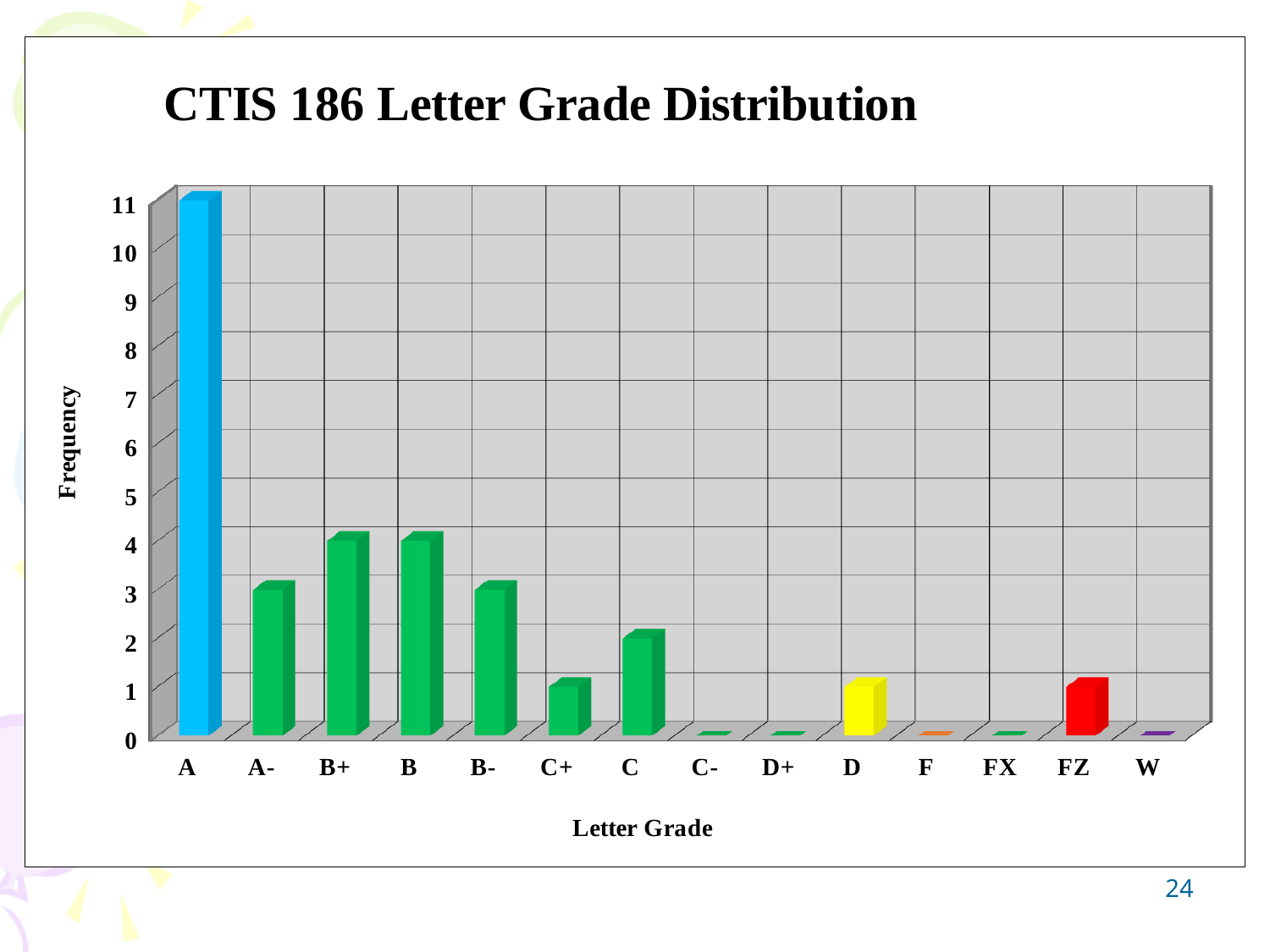
Which has a higher frequency, B- or C+? B- What is the frequency for letter grade C? 2 Is the frequency for A greater or less than 10? greater Which letter grade has the highest frequency? A How many letter grade categories are shown on the x axis? 14 What is the label of the y axis? Frequency What is the frequency for letter grade A? 11 What is the frequency for letter grade FZ? 1 What is the difference in frequency between A and B? 7 What is the title of the chart? CTIS 186 Letter Grade Distribution What kind of chart is shown on the slide? bar chart What is the frequency for letter grade B+? 4